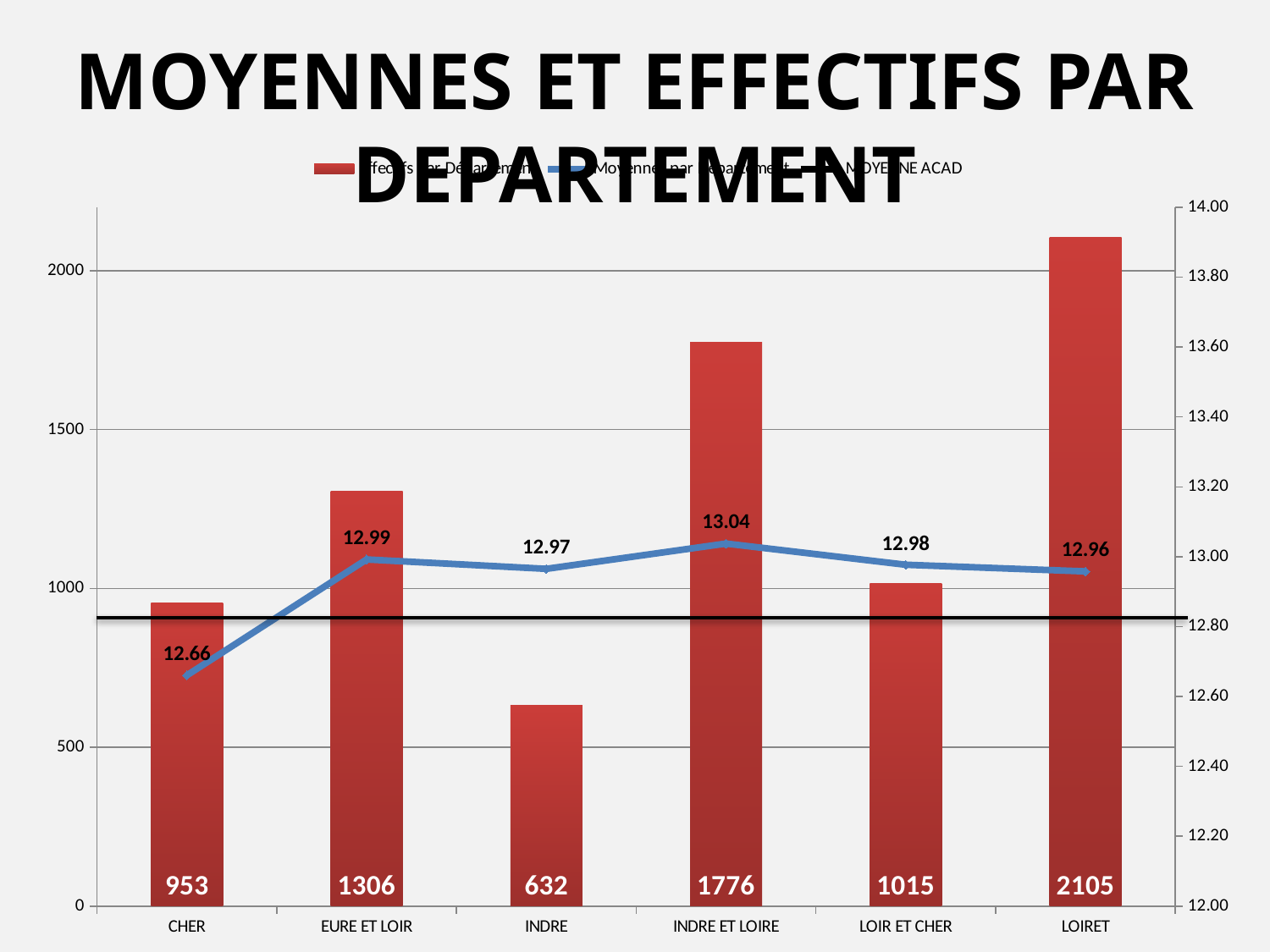
How many departments are shown on the x axis? 6 What is the value of the bar for LOIRET? 2105 Which bar is larger, EURE ET LOIR or LOIR ET CHER? EURE ET LOIR What kind of chart is shown on the slide? Bar chart with a line What is the value of the bar for CHER? 953 Which department has the tallest bar? LOIRET Which department has the lowest value on the line series? CHER What is the difference between the bar values for LOIRET and INDRE? 1473 Which department has the shortest bar? INDRE Is the black horizontal line greater or less than 13.00 on the right-hand axis? less What is the value of the line data point for INDRE ET LOIRE? 13.04 Which department has the highest value on the line series? INDRE ET LOIRE